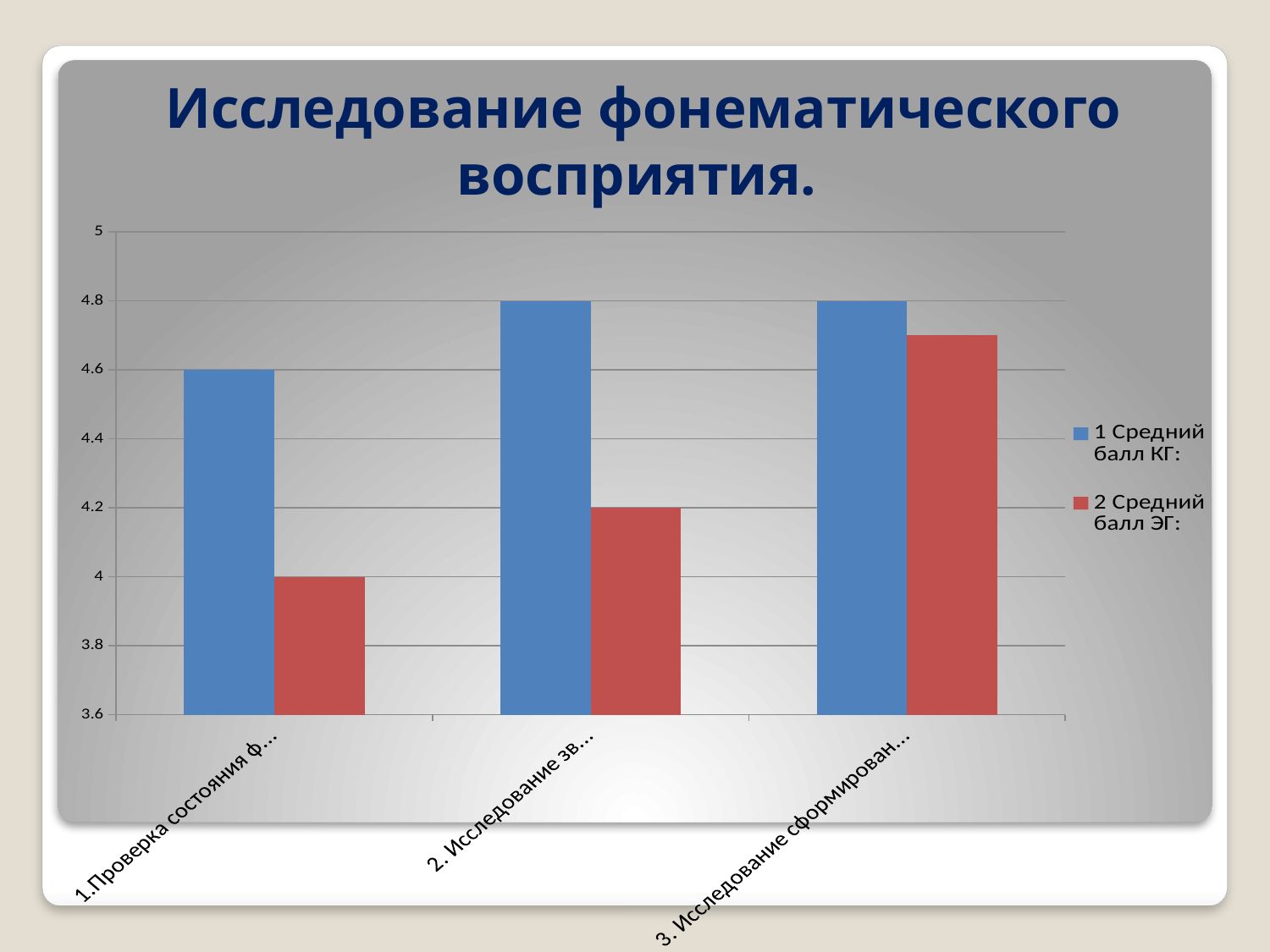
What is the difference between "1 Средний балл КГ:" and "2 Средний балл ЭГ:" for the first category? 0.6 What is the title of the chart slide? Исследование фонематического восприятия. In the third category (3. Исследование сформирован...), which series has the larger value, "1 Средний балл КГ:" or "2 Средний балл ЭГ:"? 1 Средний балл КГ: What kind of chart is shown on the slide? bar chart How many series does the legend list? 2 What is the value of "2 Средний балл ЭГ:" for the second category (2. Исследование зв...)? 4.2 Is the value of "2 Средний балл ЭГ:" for the third category greater or less than 4.6? greater For which category is "2 Средний балл ЭГ:" lowest? 1.Проверка состояния ф... How many categories are shown on the x axis? 3 What is the value of "1 Средний балл КГ:" for the second category (2. Исследование зв...)? 4.8 What is the value of "2 Средний балл ЭГ:" for the first category (1.Проверка состояния ф...)? 4 What is the value of "1 Средний балл КГ:" for the first category (1.Проверка состояния ф...)? 4.6